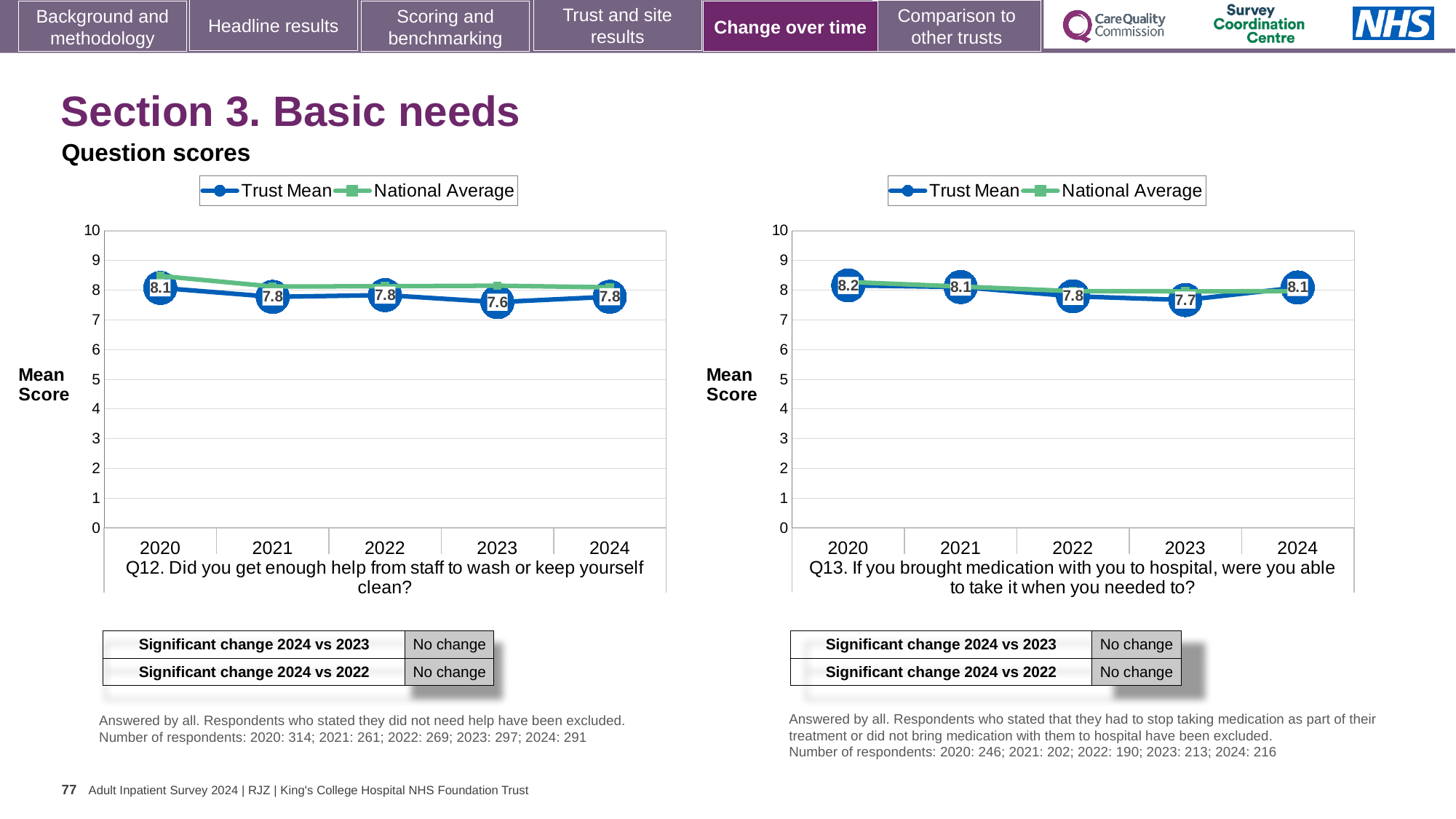
In the Q13 chart on the right, what is the difference between the Trust Mean scores for 2024 and 2023? 0.4 In the Q13 chart on the right, which year has the highest Trust Mean score? 2020 In the Q12 chart on the left, what is the difference between the Trust Mean scores for 2020 and 2023? 0.5 How many years are plotted on the x axis of the Q12 chart on the left? 5 In the Q13 chart on the right, what is the Trust Mean score for 2020? 8.2 In the Q12 chart on the left, which year has the lowest Trust Mean score? 2023 In the Q12 chart on the left, is the National Average value for 2020 greater or less than 8? greater In the Q13 chart on the right, does the Trust Mean score rise or fall from 2020 to 2023? Fall What type of chart is used for Q12 on the left? Line chart How many series does the legend of the Q13 chart on the right list? 2 In the Q12 chart on the left, what is the Trust Mean score for 2023? 7.6 In the Q13 chart on the right, is the Trust Mean score higher in 2022 or in 2024? 2024